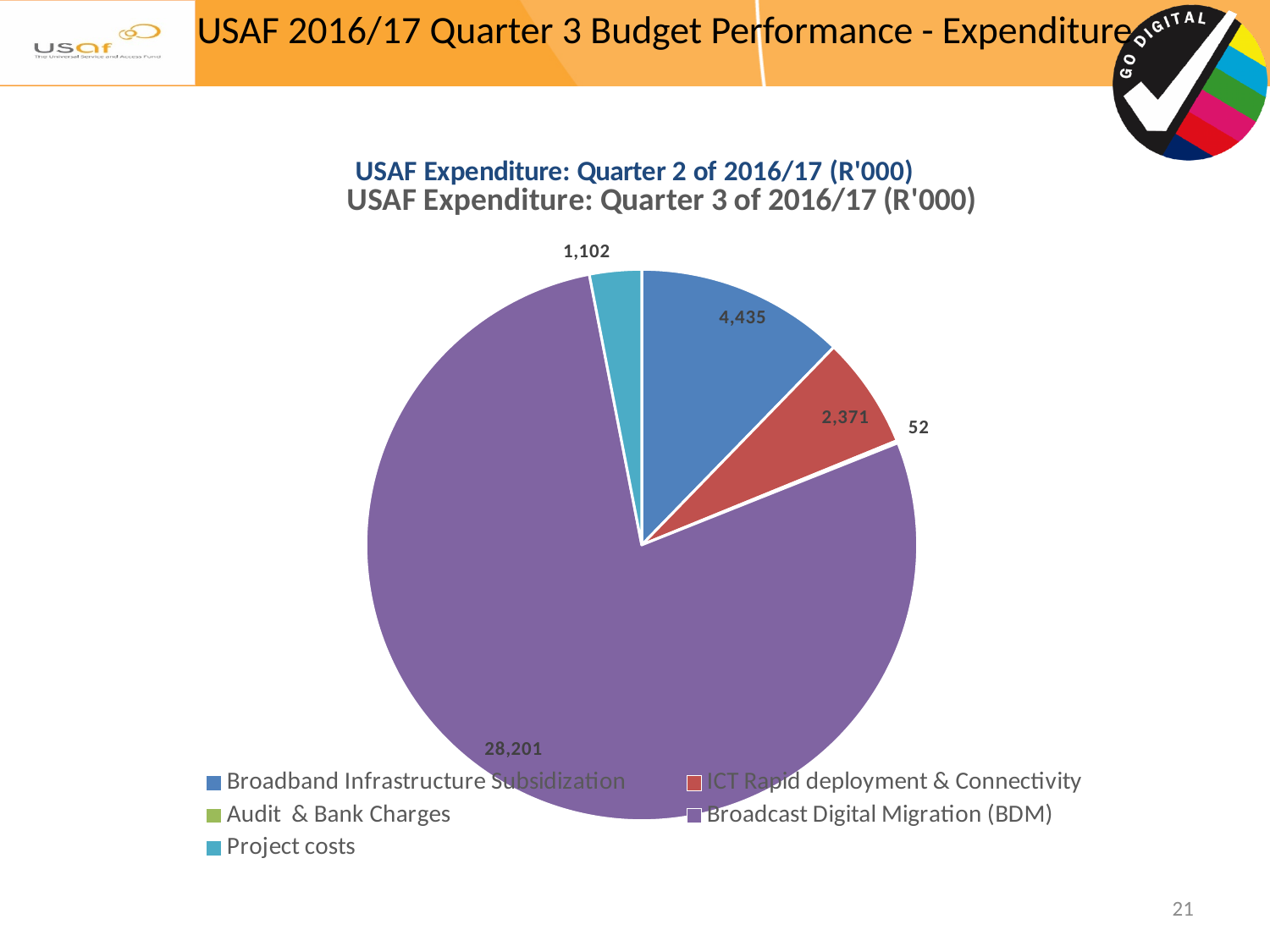
What colour is the slice for Broadcast Digital Migration (BDM)? Purple What is the value for ICT Rapid deployment & Connectivity? 2,371 What is the value for Broadcast Digital Migration (BDM)? 28,201 Which category has the largest slice of the pie? Broadcast Digital Migration (BDM) What is the value for Project costs? 1,102 Which category has the smallest slice of the pie? Audit & Bank Charges What is the value for Audit & Bank Charges? 52 What type of chart is shown on the slide? Pie chart Which is larger, ICT Rapid deployment & Connectivity or Project costs? ICT Rapid deployment & Connectivity What is the value for Broadband Infrastructure Subsidization? 4,435 What is the difference between Broadcast Digital Migration (BDM) and Broadband Infrastructure Subsidization? 23,766 How many categories does the pie chart show? 5